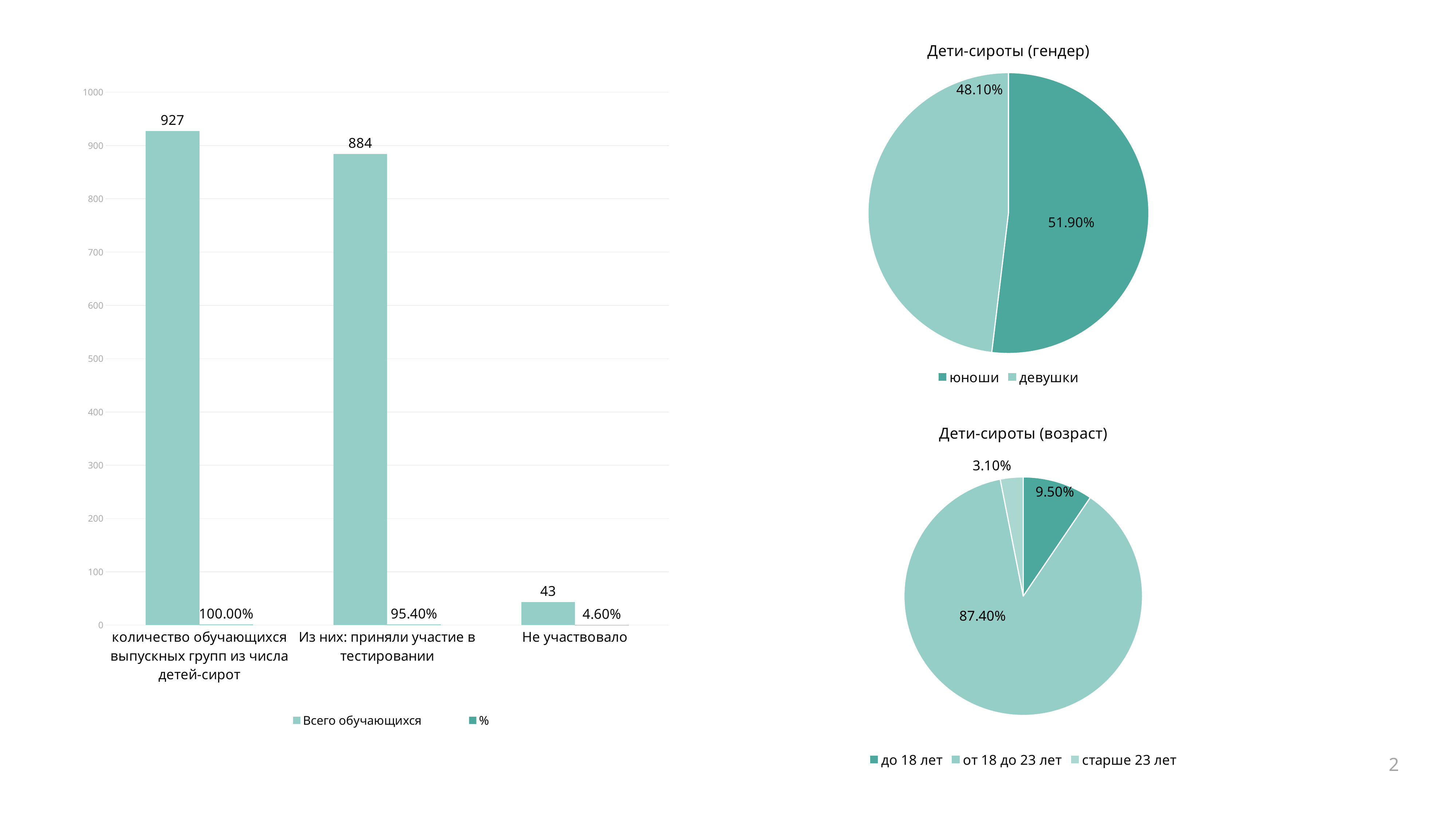
In the pie chart 'Дети-сироты (гендер)', which slice is larger, 'юноши' or 'девушки'? юноши In the bar chart on the left, what is the value of 'Всего обучающихся' for 'Из них: приняли участие в тестировании'? 884 In the pie chart 'Дети-сироты (возраст)', how many categories does the legend list? 3 In the bar chart on the left, what is the value of 'Всего обучающихся' for 'Не участвовало'? 43 In the bar chart on the left, what percentage is shown for 'Из них: приняли участие в тестировании'? 95.40% In the pie chart 'Дети-сироты (возраст)', which category has the largest share? от 18 до 23 лет In the bar chart on the left, how many series does the legend list? 2 In the bar chart on the left, which category has the highest 'Всего обучающихся' value? количество обучающихся выпускных групп из числа детей-сирот In the bar chart on the left, what is the difference between the 'Всего обучающихся' values for 'количество обучающихся выпускных групп из числа детей-сирот' and 'Из них: приняли участие в тестировании'? 43 In the pie chart 'Дети-сироты (возраст)', what share is 'старше 23 лет'? 3.10% In the pie chart 'Дети-сироты (гендер)', what share is 'юноши'? 51.90% What kind of chart is the chart on the left of the slide? bar chart